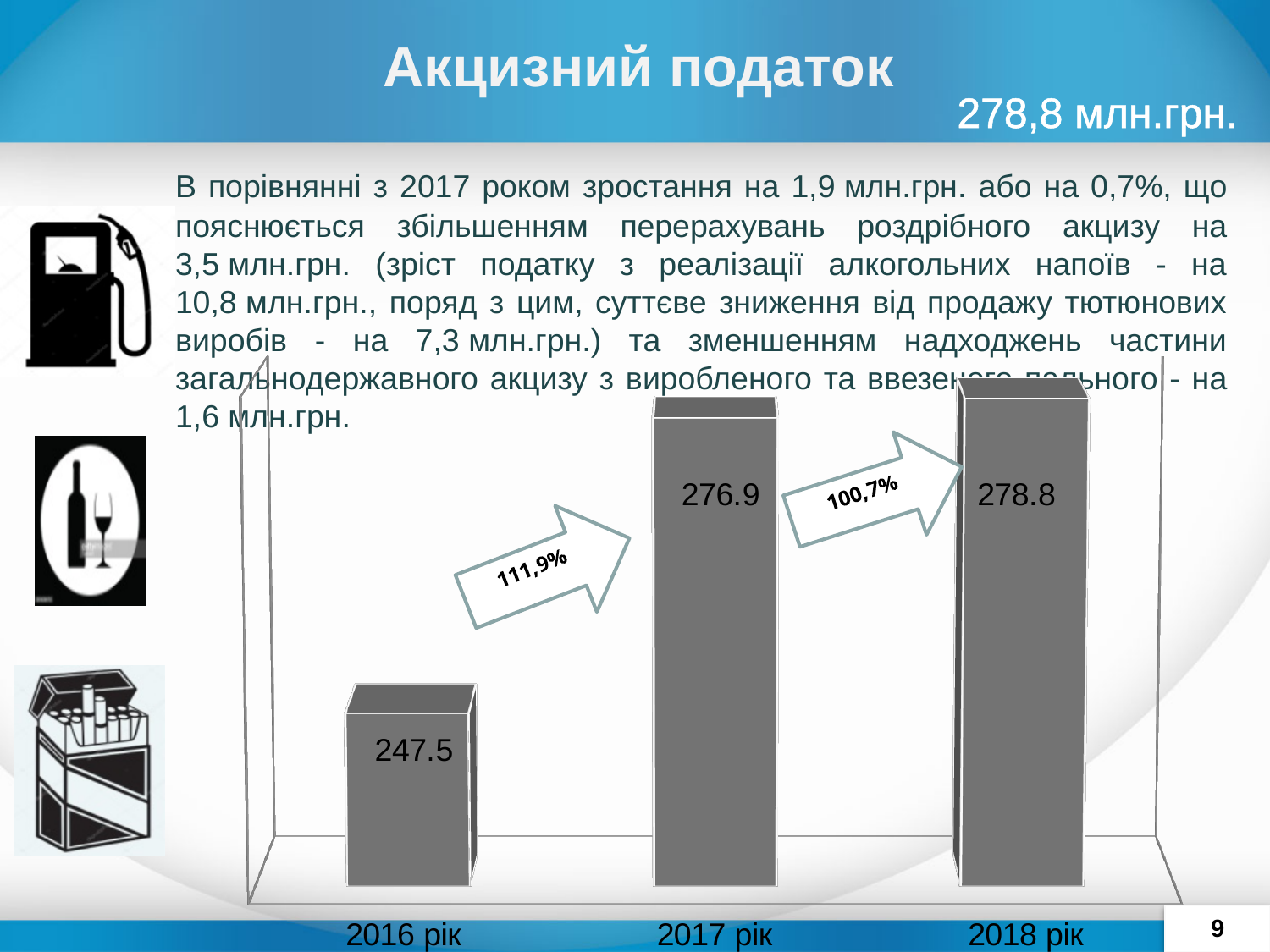
What is the difference between the values for 2018 рік and 2017 рік? 1.9 Which year has the highest value in the chart? 2018 рік What type of chart is shown on the slide? bar chart Which year has the lowest value in the chart? 2016 рік What is the value for 2016 рік? 247.5 Do the values rise or fall from 2016 рік to 2018 рік? rise How many bars (categories) does the chart show? 3 What is the value for 2017 рік? 276.9 What percentage is shown on the arrow between the 2017 рік and 2018 рік bars? 100,7% Which is larger, the value for 2016 рік or the value for 2017 рік? 2017 рік What is the difference between the values for 2017 рік and 2016 рік? 29.4 What is the value for 2018 рік? 278.8